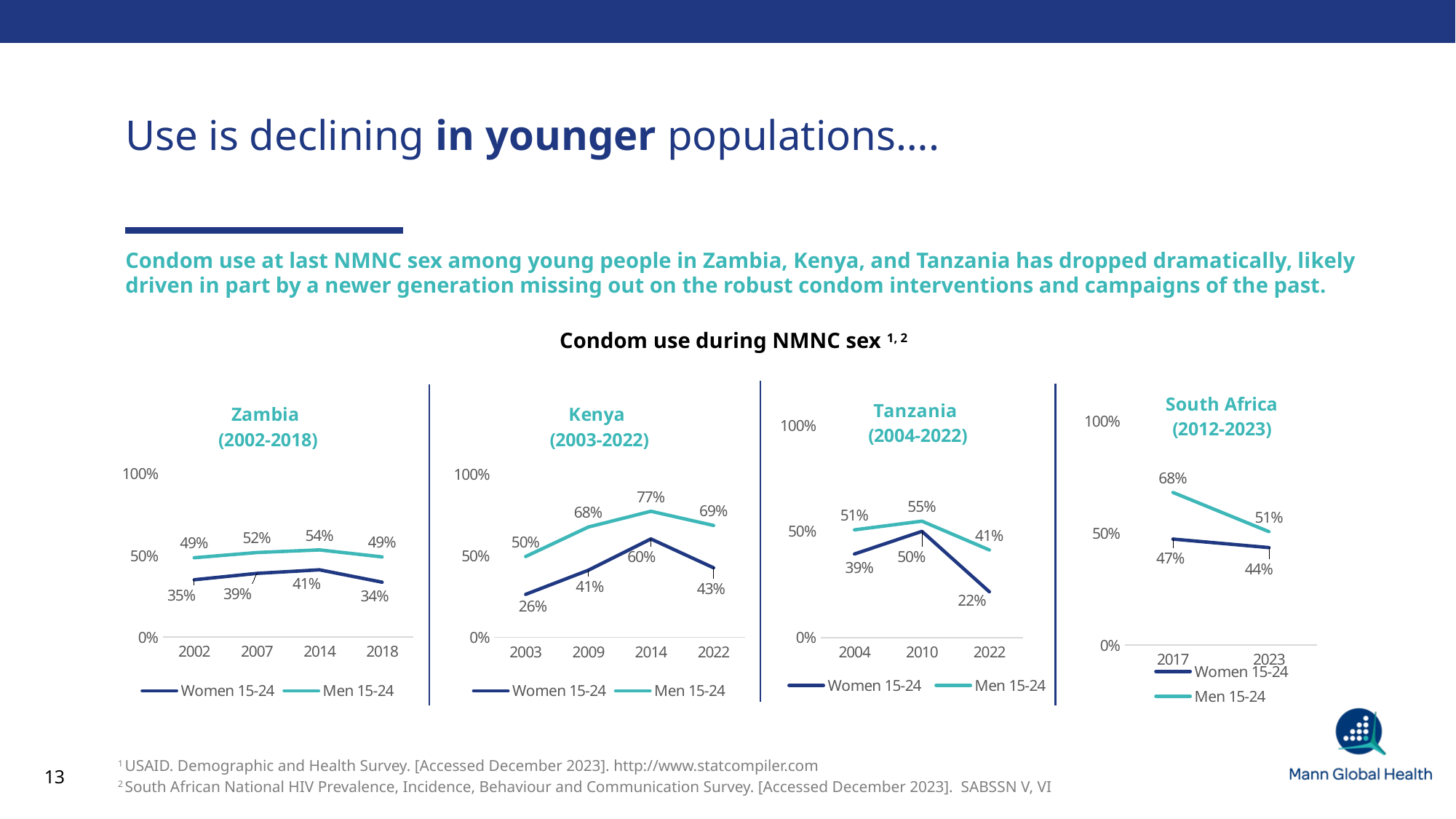
In the Zambia chart, what is the value for Women 15-24 in 2018? 34% In the Tanzania chart, what is the value for Women 15-24 in 2022? 22% In the Kenya chart, what is the value for Men 15-24 in 2014? 77% What kind of chart is the South Africa chart? Line chart In the Tanzania chart, in which year is the Men 15-24 value lowest? 2022 In the South Africa chart, what is the value for Men 15-24 in 2023? 51% In the South Africa chart, what is the difference between the Men 15-24 values in 2017 and 2023? 17% How many years are plotted on the x axis of the Tanzania chart? 3 How many series does the legend of the Kenya chart list? 2 In the Zambia chart, which is larger in 2014: the Women 15-24 value or the Men 15-24 value? Men 15-24 In the Kenya chart, in which year is the Women 15-24 value highest? 2014 In the South Africa chart, do the Women 15-24 values rise or fall from 2017 to 2023? Fall